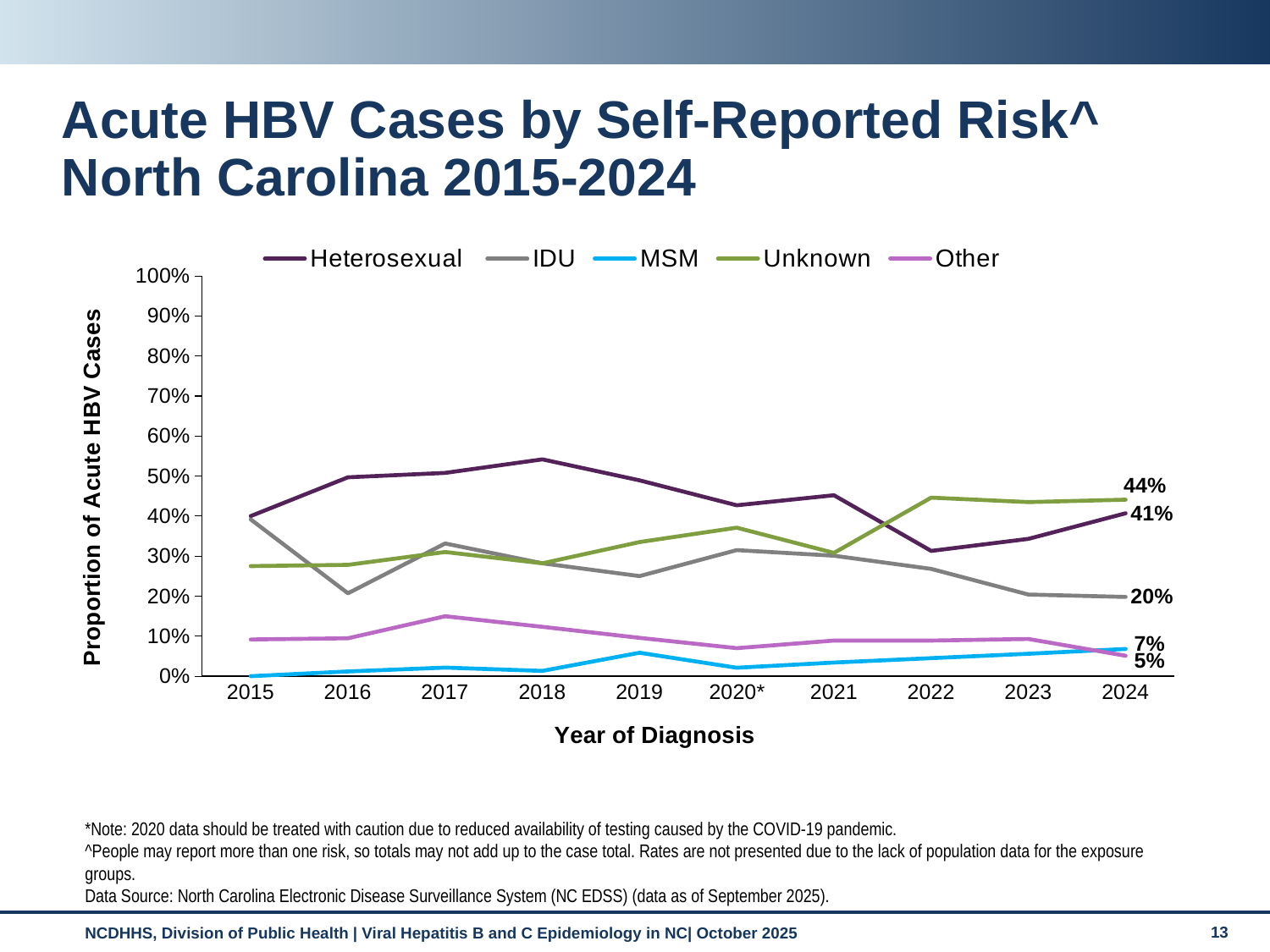
What is the value for IDU in 2024? 20% How many years are shown on the x axis? 10 Which risk category has the lowest proportion in 2024? Other What is the value for Unknown in 2024? 44% Is the value for Heterosexual in 2018 greater or less than 50%? greater What is the value for MSM in 2024? 7% In 2018, which is larger: the Heterosexual value or the IDU value? Heterosexual What kind of chart is shown on the slide? Line chart How many series does the legend list? 5 Which risk category has the highest proportion in 2024? Unknown What is the value for Heterosexual in 2024? 41% What is the difference between the IDU and MSM values in 2024? 13 percentage points